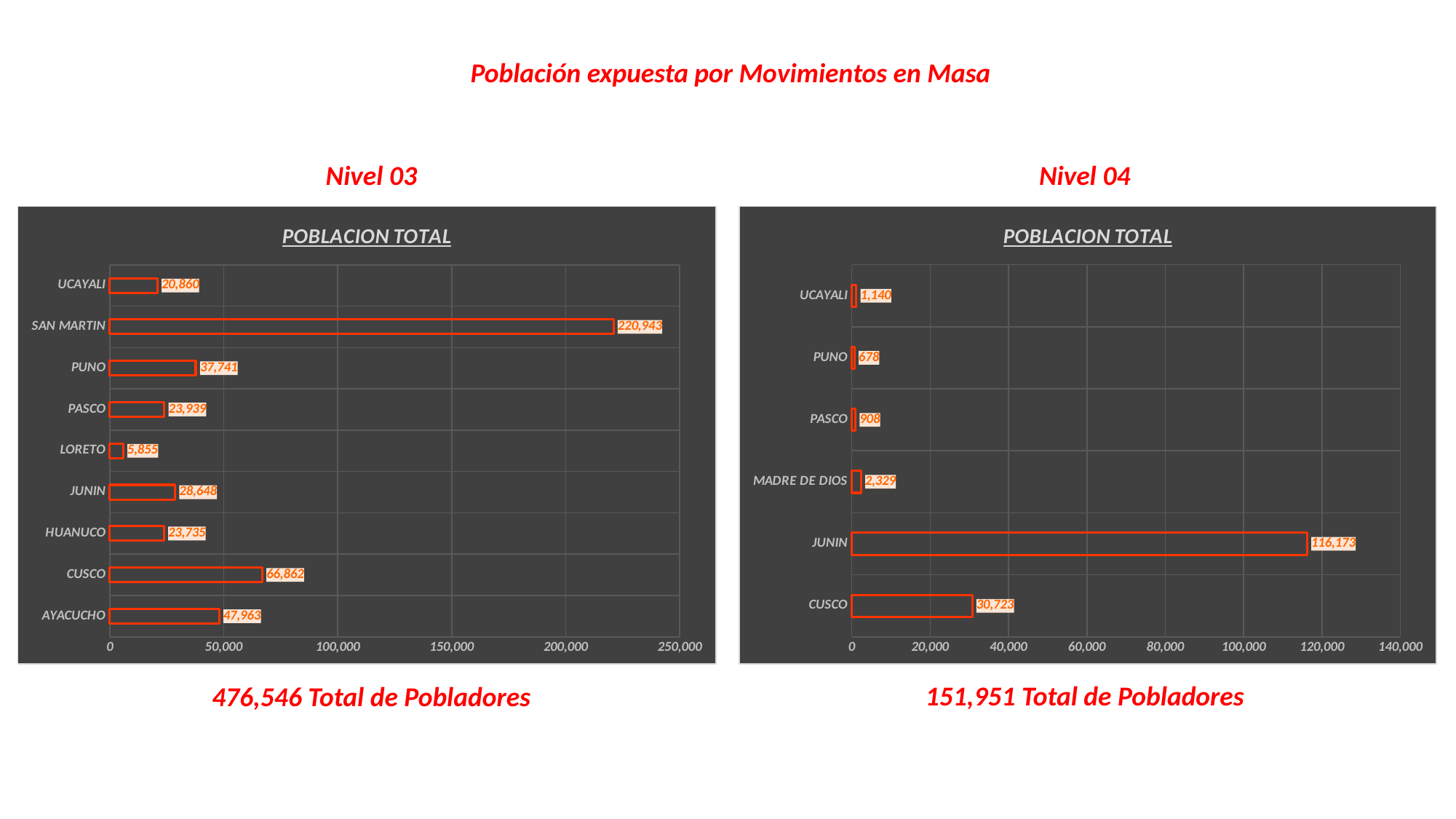
In the Nivel 04 chart on the right, what is the value for MADRE DE DIOS? 2,329 In the Nivel 03 chart on the left, which is larger, the value for PUNO or the value for JUNIN? PUNO In the Nivel 03 chart on the left, what is the difference between the values for CUSCO and AYACUCHO? 18,899 In the Nivel 03 chart on the left, what is the value for SAN MARTIN? 220,943 In the Nivel 04 chart on the right, what is the difference between the values for JUNIN and CUSCO? 85,450 How many categories are shown in the Nivel 04 chart on the right? 6 In the Nivel 03 chart on the left, what is the value for LORETO? 5,855 In the Nivel 03 chart on the left, which category has the lowest value? LORETO In the Nivel 04 chart on the right, which category has the highest value? JUNIN In the Nivel 04 chart on the right, which category has the lowest value? PUNO What kind of chart is the Nivel 04 chart on the right? Bar chart How many categories are shown in the Nivel 03 chart on the left? 9